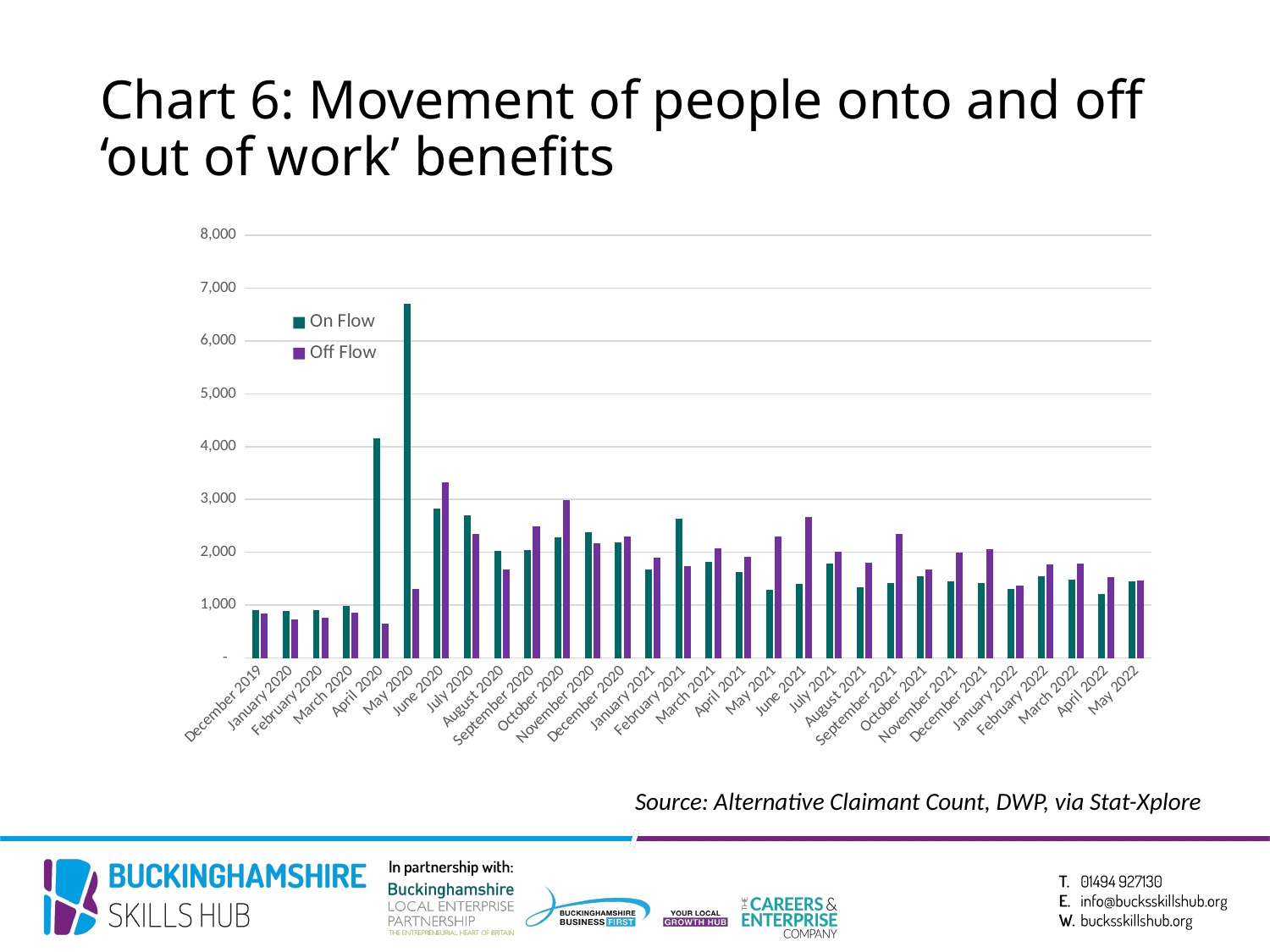
Which month has the highest On Flow value? May 2020 What are the two series named in the legend? On Flow and Off Flow Is the On Flow value for May 2020 greater or less than 6,000? greater Which month has the lowest Off Flow value? April 2020 Is the On Flow value for April 2020 greater or less than 4,000? greater What kind of chart is shown on the slide? bar chart Does the On Flow value rise or fall from May 2020 to August 2020? fall How many series does the legend list? 2 Is the Off Flow value for April 2020 greater or less than 1,000? less In June 2020, which is larger, On Flow or Off Flow? Off Flow Which month has the highest Off Flow value? June 2020 How many months are shown along the x axis? 30